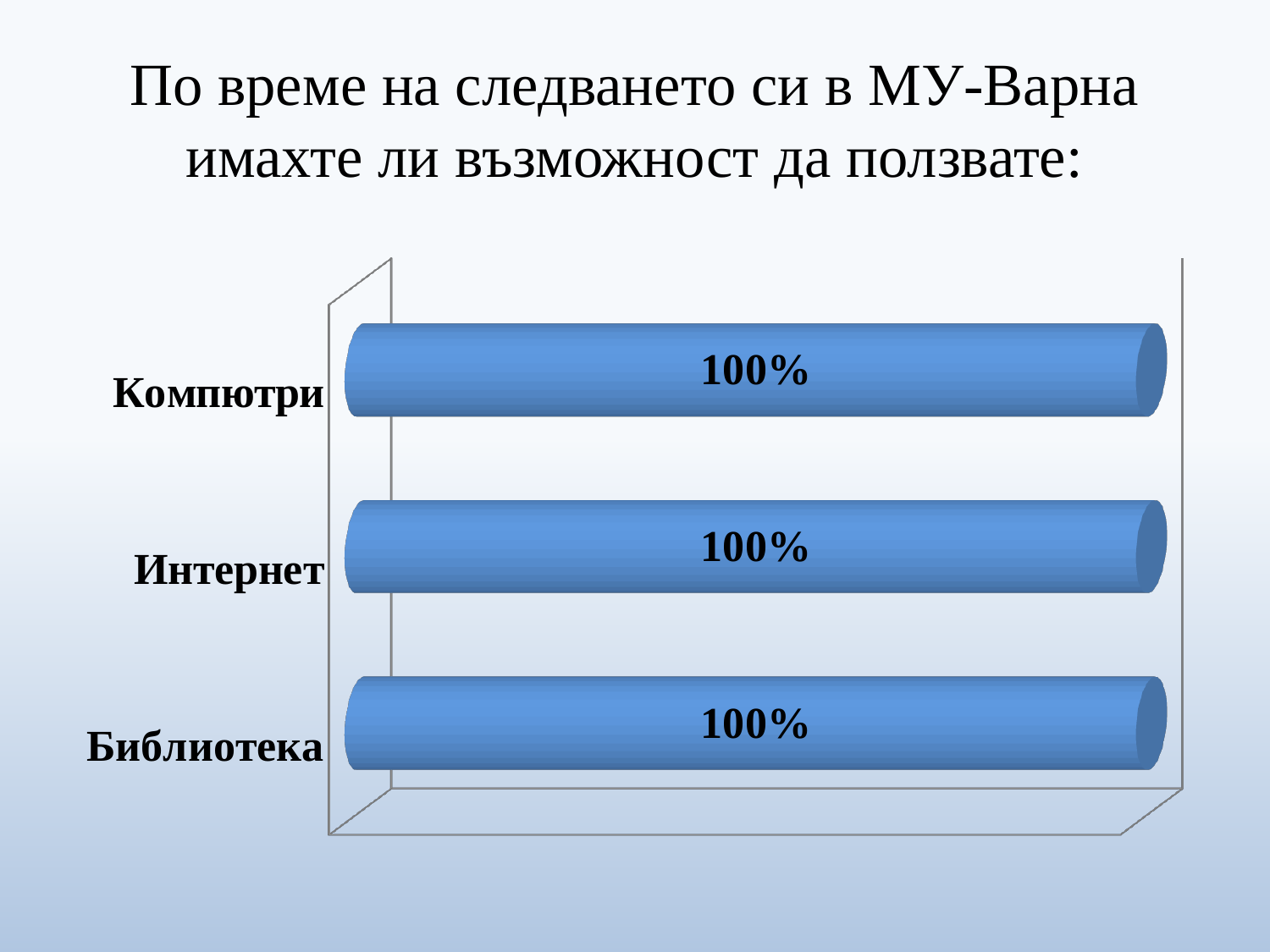
What colour are the bars in the chart? Blue What kind of chart is shown on the slide? Bar chart What is the value for Компютри? 100% How many categories are shown in the chart? 3 Do all three categories have the same value? Yes What is the value for Интернет? 100% Which category is listed at the top of the chart? Компютри What is the difference between the values for Компютри and Библиотека? 0% What is the value for Библиотека? 100%